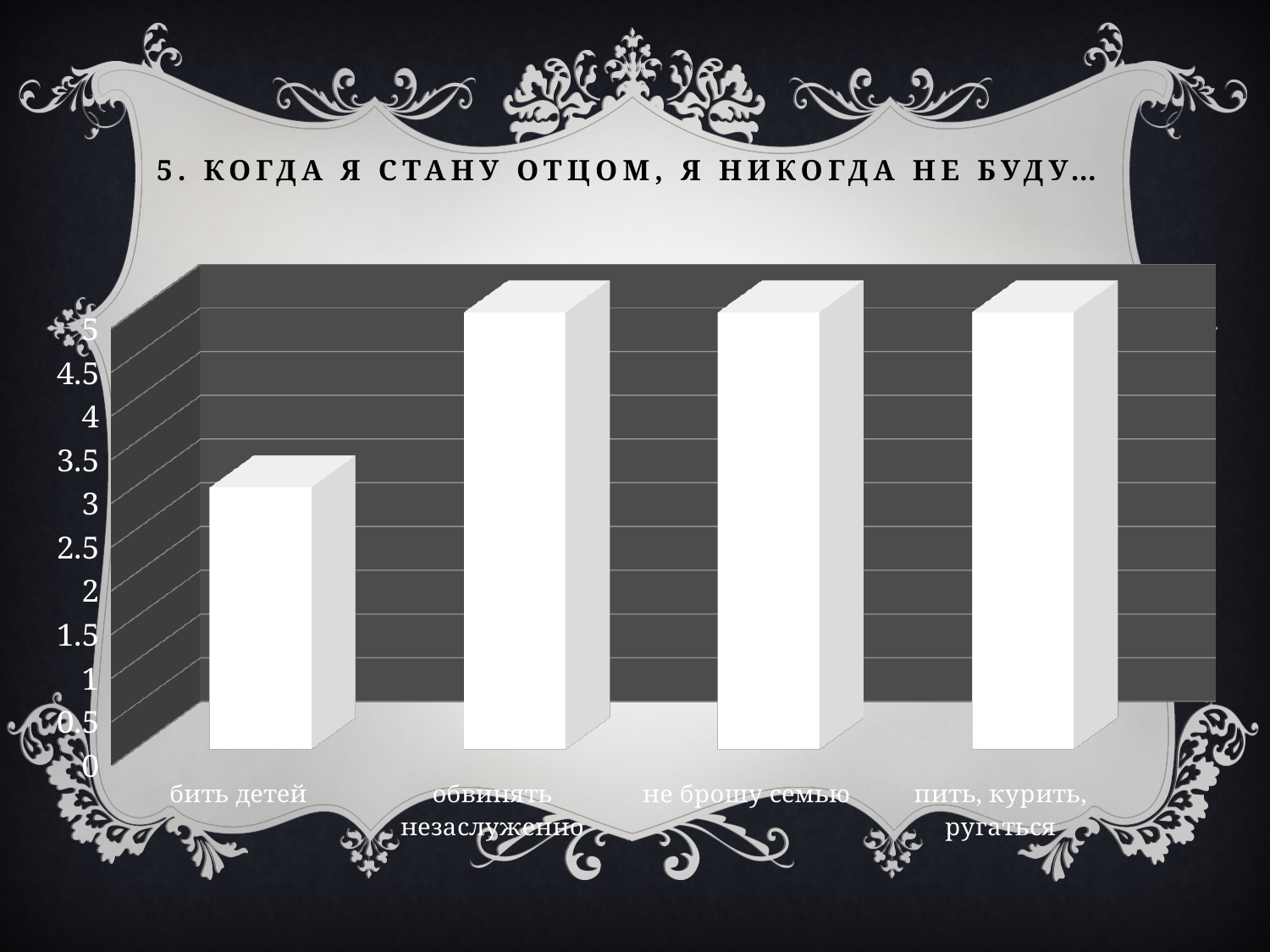
Is the value for "обвинять незаслуженно" greater or less than 4? greater What kind of chart is shown on the slide? bar chart Is the value for "бить детей" greater or less than 2? greater Which category has the lowest value in the chart? бить детей What is the highest value shown on the vertical axis of the chart? 5 What is the title of the chart on the slide? 5. Когда я стану отцом, я никогда не буду… Which is larger, the value for "бить детей" or the value for "не брошу семью"? не брошу семью Is the value for "не брошу семью" greater or less than 4? greater Which is larger, the value for "обвинять незаслуженно" or the value for "бить детей"? обвинять незаслуженно How many categories are shown on the x axis of the chart? 4